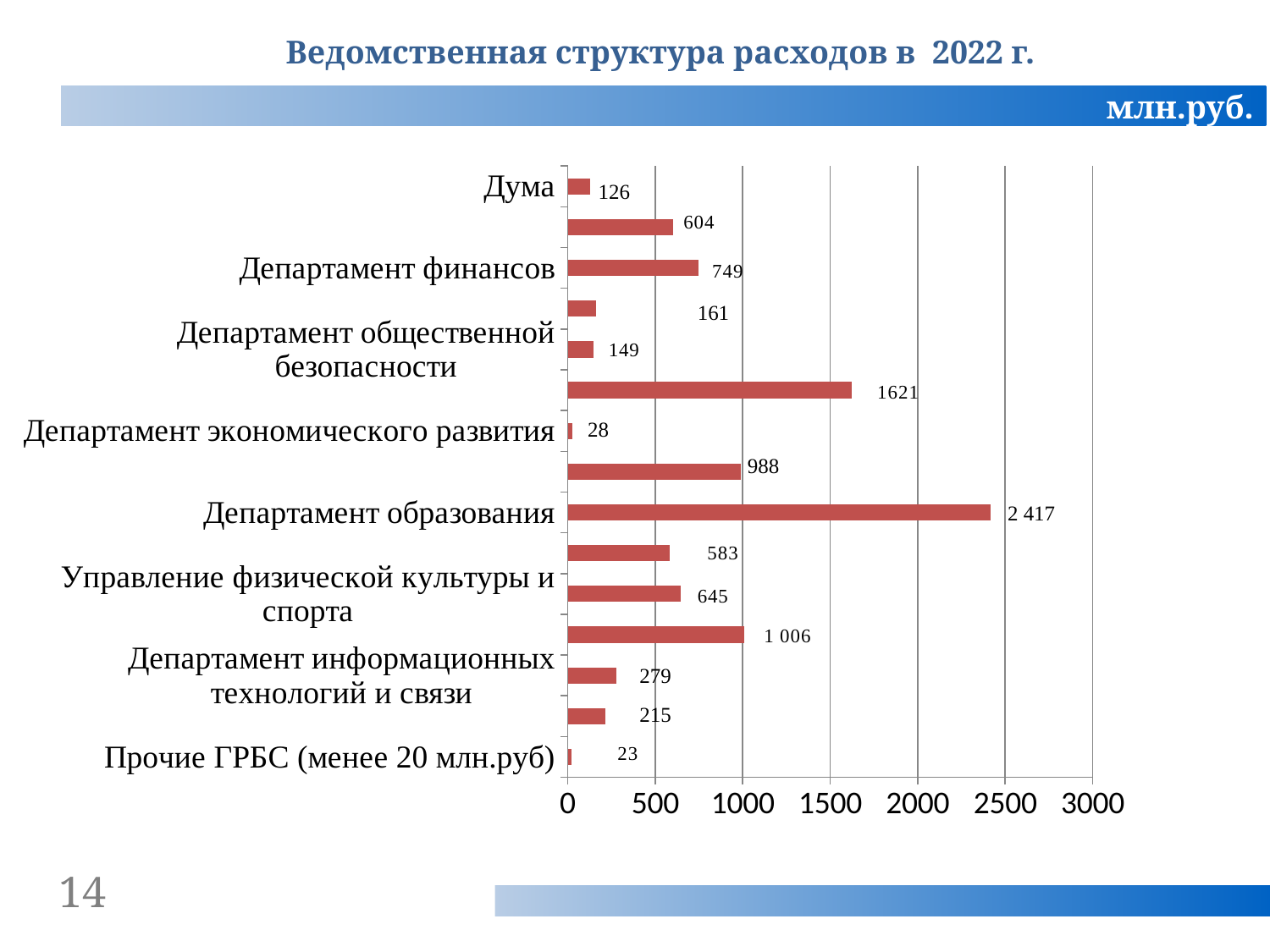
What is the difference between the values for Департамент финансов and Управление физической культуры и спорта? 104 How many bars are plotted in the chart? 15 Which labeled category has the lowest value? Прочие ГРБС (менее 20 млн.руб) What is the value for Дума? 126 What kind of chart is shown on the slide? bar chart What is the value for Департамент финансов? 749 Which is larger, the value for Департамент информационных технологий и связи or the value for Департамент общественной безопасности? Департамент информационных технологий и связи What is the value for Департамент образования? 2 417 What is the value for Департамент экономического развития? 28 Which labeled category has the highest value? Департамент образования What is the value for Прочие ГРБС (менее 20 млн.руб)? 23 Is the value for Департамент образования greater or less than 2000? greater